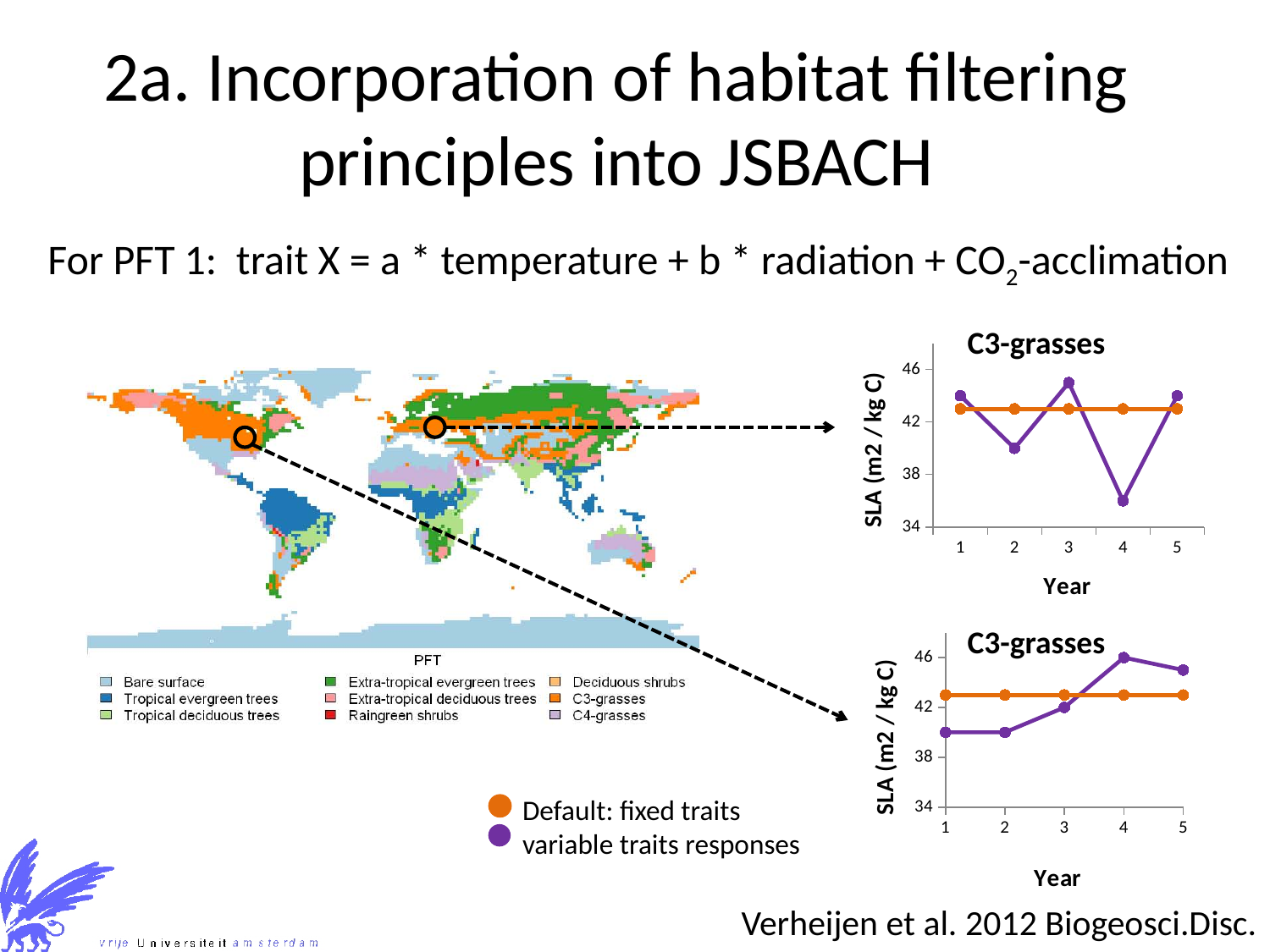
In the top C3-grasses chart, how many years are plotted on the x axis? 5 In the top C3-grasses chart, is the variable traits responses value in year 3 greater or less than 42? greater In the top C3-grasses chart, which series has the larger value in year 2, Default: fixed traits or variable traits responses? Default: fixed traits In the top C3-grasses chart, is the variable traits responses value in year 4 greater or less than 38? less In the top C3-grasses chart, in which year is the variable traits responses value highest? 3 How many series does the legend list for the C3-grasses charts? 2 In the top C3-grasses chart, in which year is the variable traits responses value lowest? 4 What is the y-axis label of the C3-grasses charts? SLA (m2 / kg C) In the bottom C3-grasses chart, does the variable traits responses series generally rise or fall from year 1 to year 5? rise In the bottom C3-grasses chart, in which year is the variable traits responses value highest? 4 What kind of chart is the top C3-grasses chart? line chart In the bottom C3-grasses chart, is the variable traits responses value in year 1 greater or less than 42? less